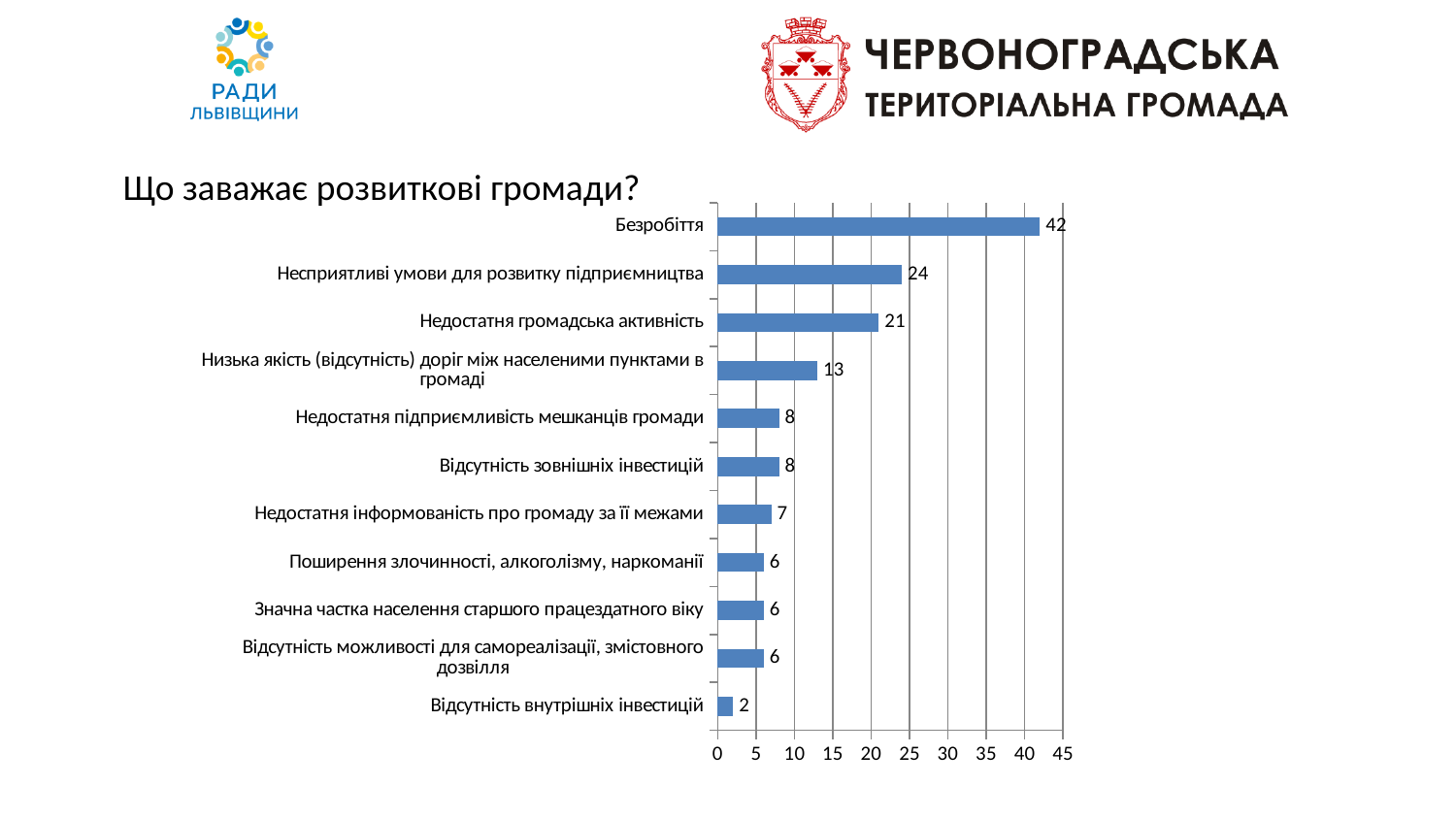
What is the difference between the values for Безробіття and Несприятливі умови для розвитку підприємництва? 18 Which category has the highest value? Безробіття Is the value for Безробіття greater or less than 40? greater What is the value for Відсутність внутрішніх інвестицій? 2 What is the value for Безробіття? 42 What is the value for Недостатня громадська активність? 21 Which is larger: the value for Недостатня громадська активність or the value for Низька якість (відсутність) доріг між населеними пунктами в громаді? Недостатня громадська активність Which category has the lowest value? Відсутність внутрішніх інвестицій What is the value for Несприятливі умови для розвитку підприємництва? 24 How many categories are shown in the chart? 11 What kind of chart is shown on the slide? bar chart What is the title of the chart? Що заважає розвиткові громади?